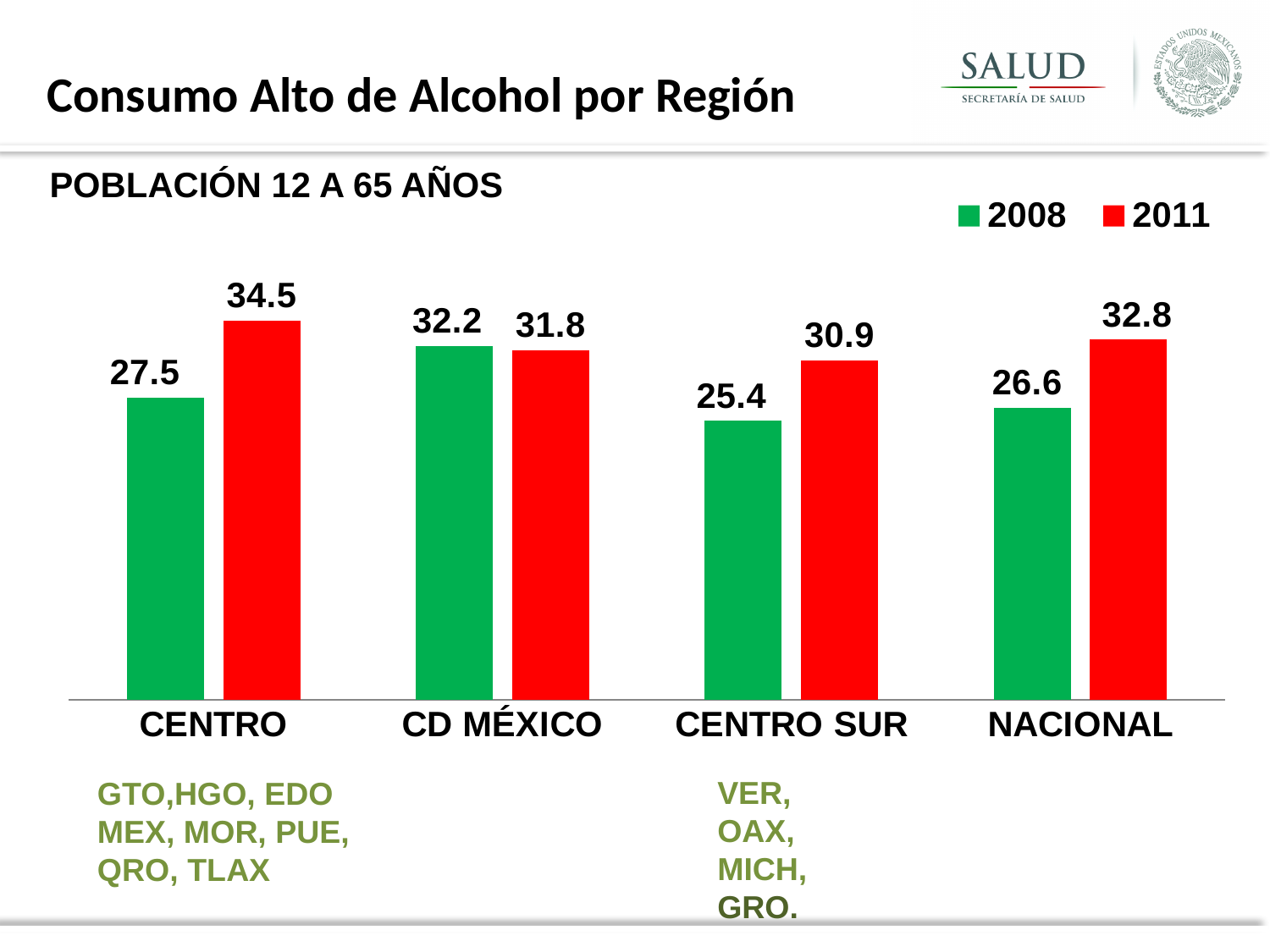
For CD MÉXICO, which year has the larger value, 2008 or 2011? 2008 What kind of chart is shown on the slide? Bar chart How many regions are shown on the x axis? 4 What is the difference between the 2011 and 2008 values for CENTRO? 7.0 What is the difference between the 2011 and 2008 values for NACIONAL? 6.2 What is the 2008 value for CENTRO? 27.5 What is the 2011 value for CENTRO SUR? 30.9 Which colour represents the 2011 series in the legend? Red Which region has the highest 2011 value? CENTRO What is the 2011 value for NACIONAL? 32.8 How many series does the legend list? 2 Which region has the lowest 2008 value? CENTRO SUR